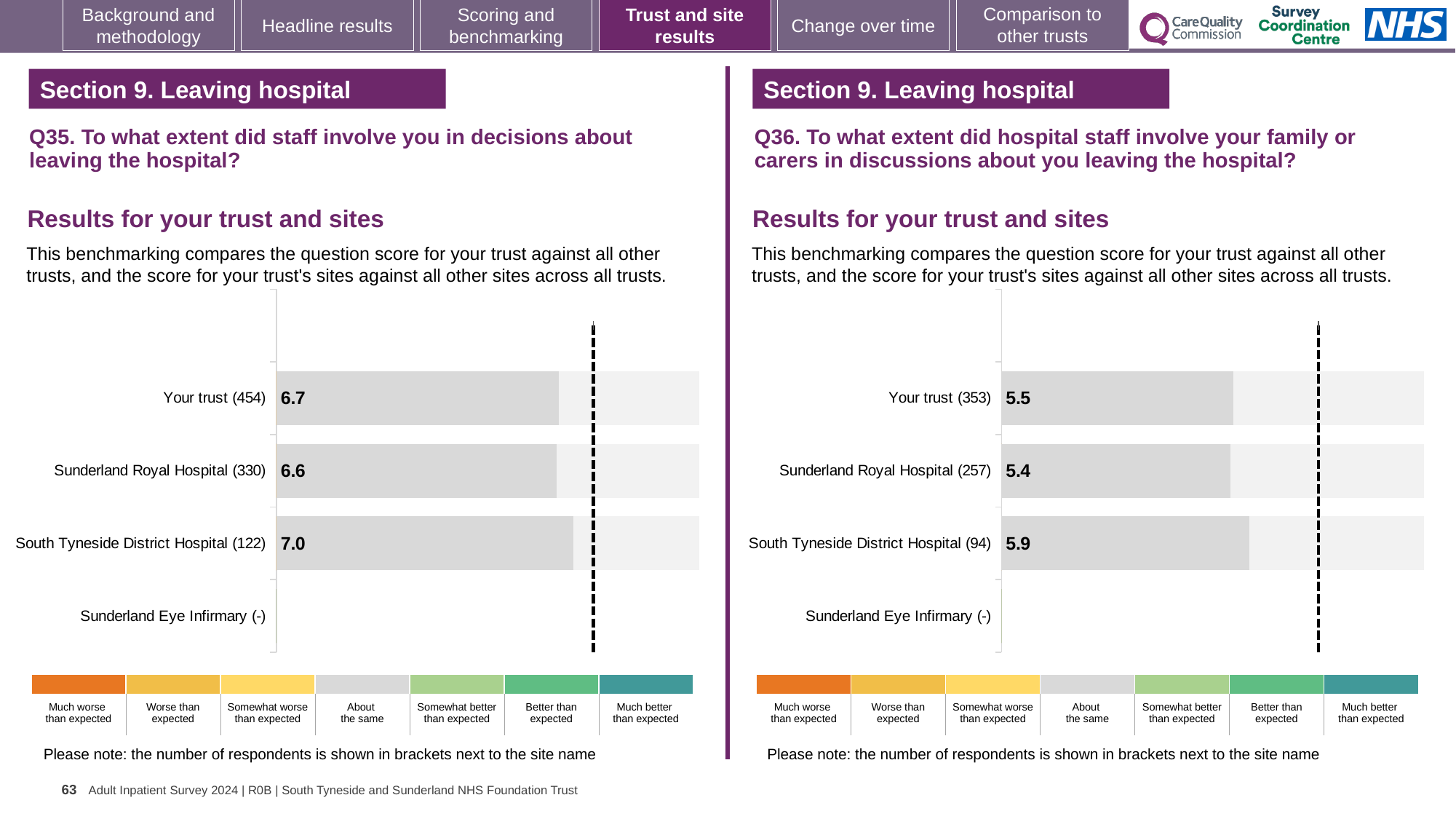
In the Q36 chart on the right, what is the difference between the scores for South Tyneside District Hospital and Your trust? 0.4 How many rows (trust and sites) are listed in the Q35 chart on the left? 4 What kind of chart is used for the Q36 results on the right? Bar chart In the Q35 chart on the left, what is the score for Your trust? 6.7 In the Q36 chart on the right, what is the score for Sunderland Royal Hospital? 5.4 In the Q35 chart on the left, what is the score for South Tyneside District Hospital? 7.0 In the Q36 chart on the right, which of the sites with a score shown has the lowest score? Sunderland Royal Hospital In the Q36 chart on the right, which is larger: the score for Your trust or the score for South Tyneside District Hospital? South Tyneside District Hospital In the Q35 chart on the left, what is the difference between the scores for South Tyneside District Hospital and Sunderland Royal Hospital? 0.4 In the Q35 chart on the left, which site has the highest score? South Tyneside District Hospital In the Q35 chart on the left, how many respondents are shown in brackets for Your trust? 454 In the Q36 chart on the right, what is the score for South Tyneside District Hospital? 5.9